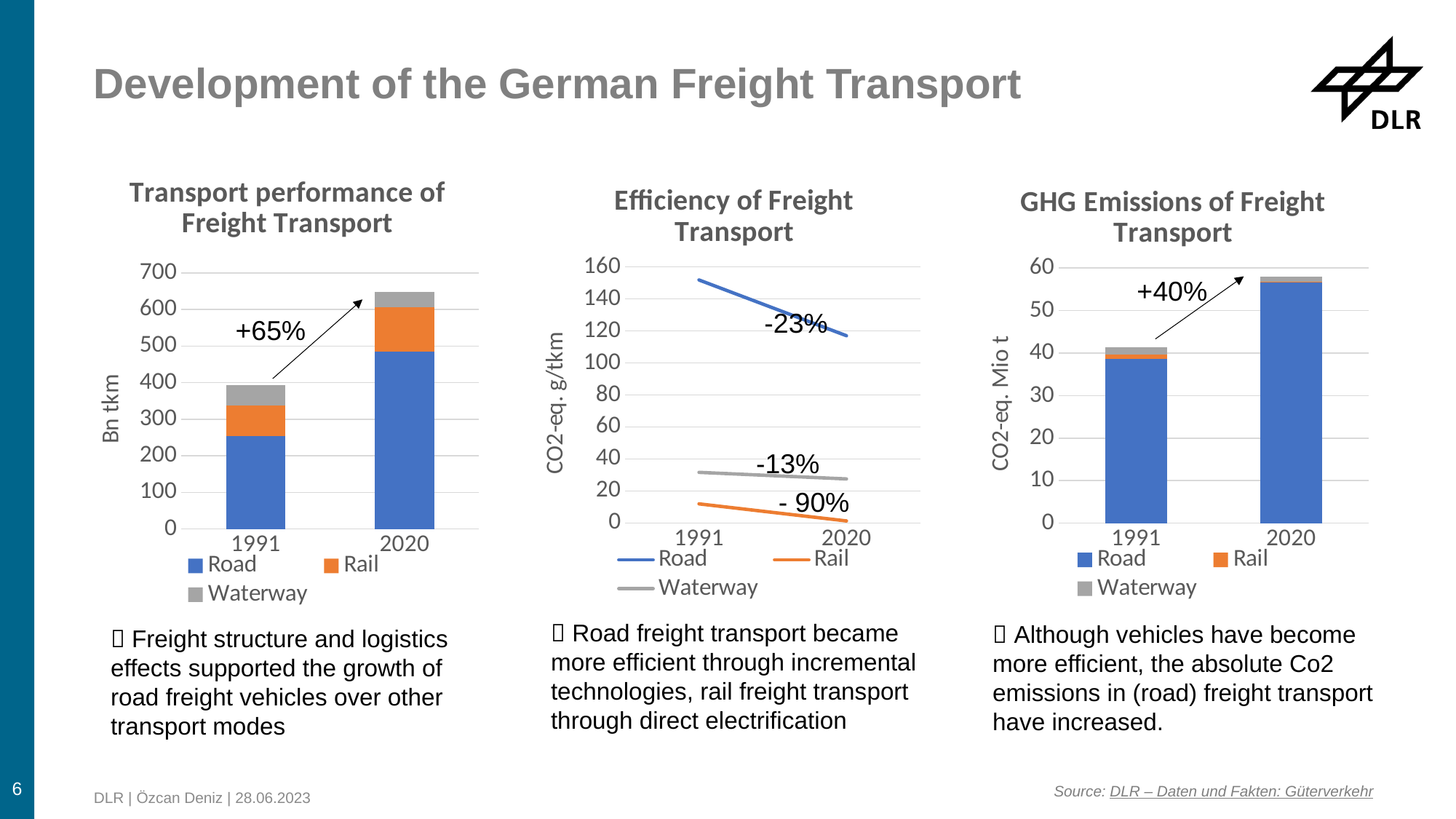
What kind of chart is the 'Transport performance of Freight Transport' chart? bar chart In the 'Transport performance of Freight Transport' chart, how many series does the legend list? 3 In the 'Efficiency of Freight Transport' chart, does the Road line rise or fall from 1991 to 2020? fall In the 'Efficiency of Freight Transport' chart, how many years are shown on the x axis? 2 In the 'GHG Emissions of Freight Transport' chart, is the total height of the 2020 bar greater or less than 50? greater What percentage change is annotated on the 'Transport performance of Freight Transport' chart? +65% In the 'Efficiency of Freight Transport' chart, is the Road value for 2020 greater or less than 100? greater In the 'Efficiency of Freight Transport' chart, which series has the highest value in 2020? Road What kind of chart is the 'Efficiency of Freight Transport' chart? line chart In the 'Transport performance of Freight Transport' chart, is the Road value for 1991 greater or less than 300? less In the 'Efficiency of Freight Transport' chart, what percentage change is annotated for the Rail line? - 90% In the 'Efficiency of Freight Transport' chart, which is higher in 1991: Road or Waterway? Road